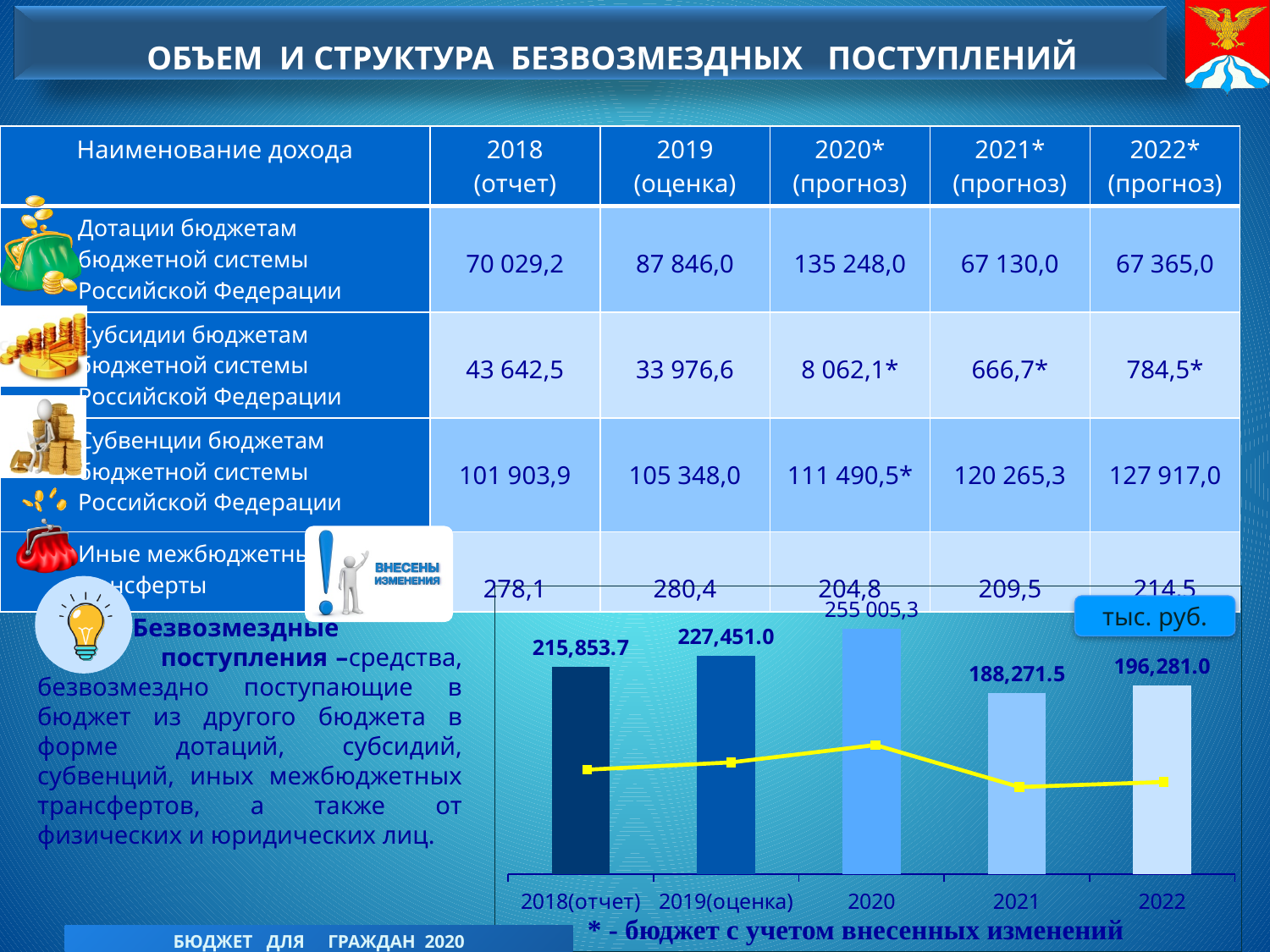
Which year has the lowest bar in the chart? 2021 What is the value of the bar for 2022 in the chart? 196,281.0 What is the value of the bar for 2019(оценка) in the chart? 227,451.0 Which year has the highest bar in the chart? 2020 What is the value of the bar for 2018(отчет) in the chart? 215,853.7 What unit is indicated in the label at the top right of the chart? тыс. руб. By how much does the 2019(оценка) bar exceed the 2018(отчет) bar in the chart? 11,597.3 Which bar is larger in the chart, 2019(оценка) or 2022? 2019(оценка) What is the value of the bar for 2020 in the chart? 255 005,3 What is the value of the bar for 2021 in the chart? 188,271.5 What kind of chart is shown at the bottom of the slide? Bar chart with a line overlay How many years are shown on the x axis of the chart? 5